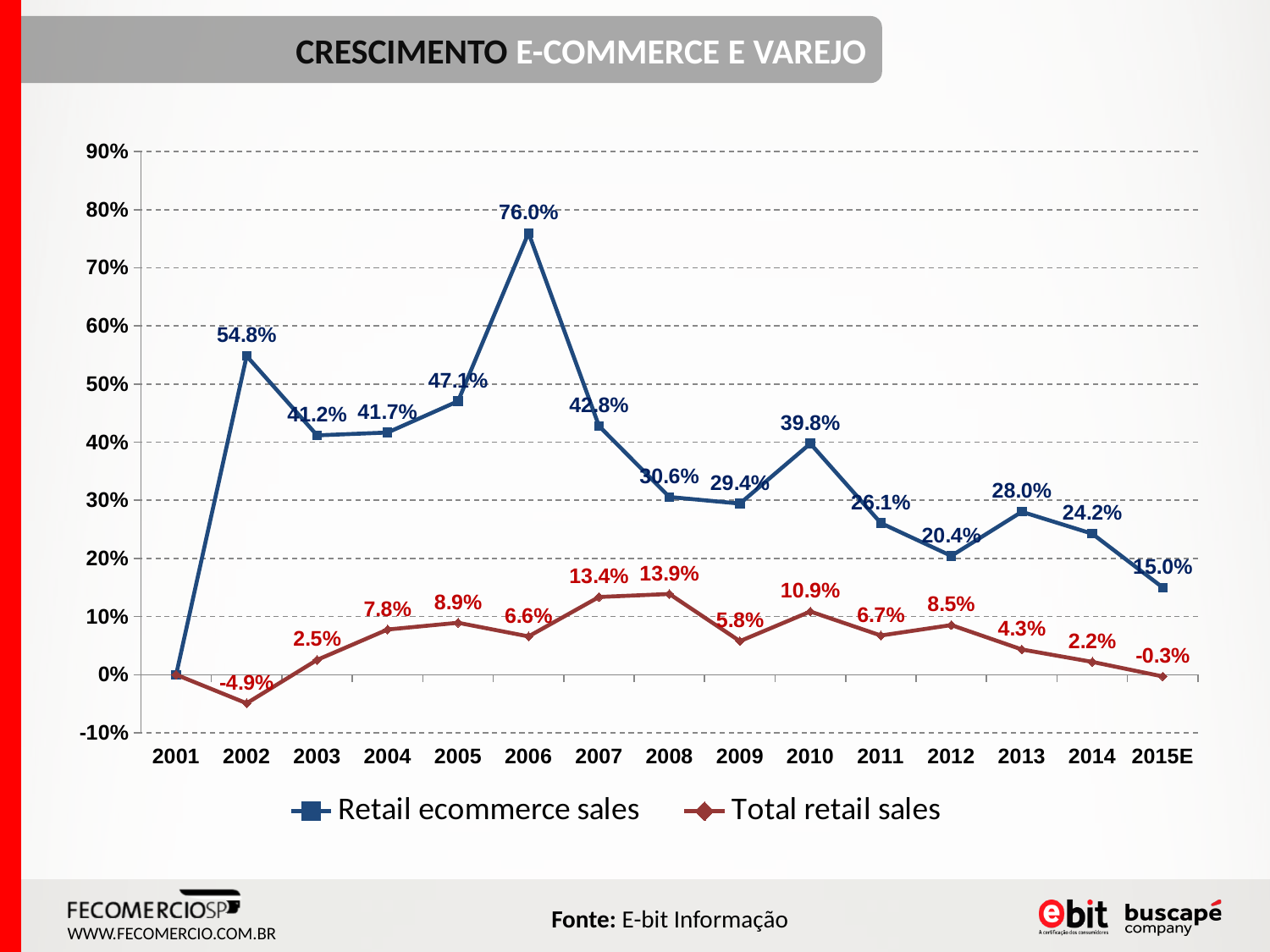
Which is larger: Total retail sales in 2007 or in 2008? 2008 In which year is Retail ecommerce sales highest? 2006 Does Retail ecommerce sales rise or fall from 2010 to 2012? Fall How many years are shown on the x axis? 15 In which year is Total retail sales lowest? 2002 What is the value for Retail ecommerce sales in 2006? 76.0% What type of chart is shown on the slide? Line chart How many series does the legend list? 2 What is the value for Total retail sales in 2010? 10.9% What is the difference between Retail ecommerce sales and Total retail sales in 2006? 69.4 percentage points What is the value for Retail ecommerce sales in 2015E? 15.0% Which series is drawn in red? Total retail sales